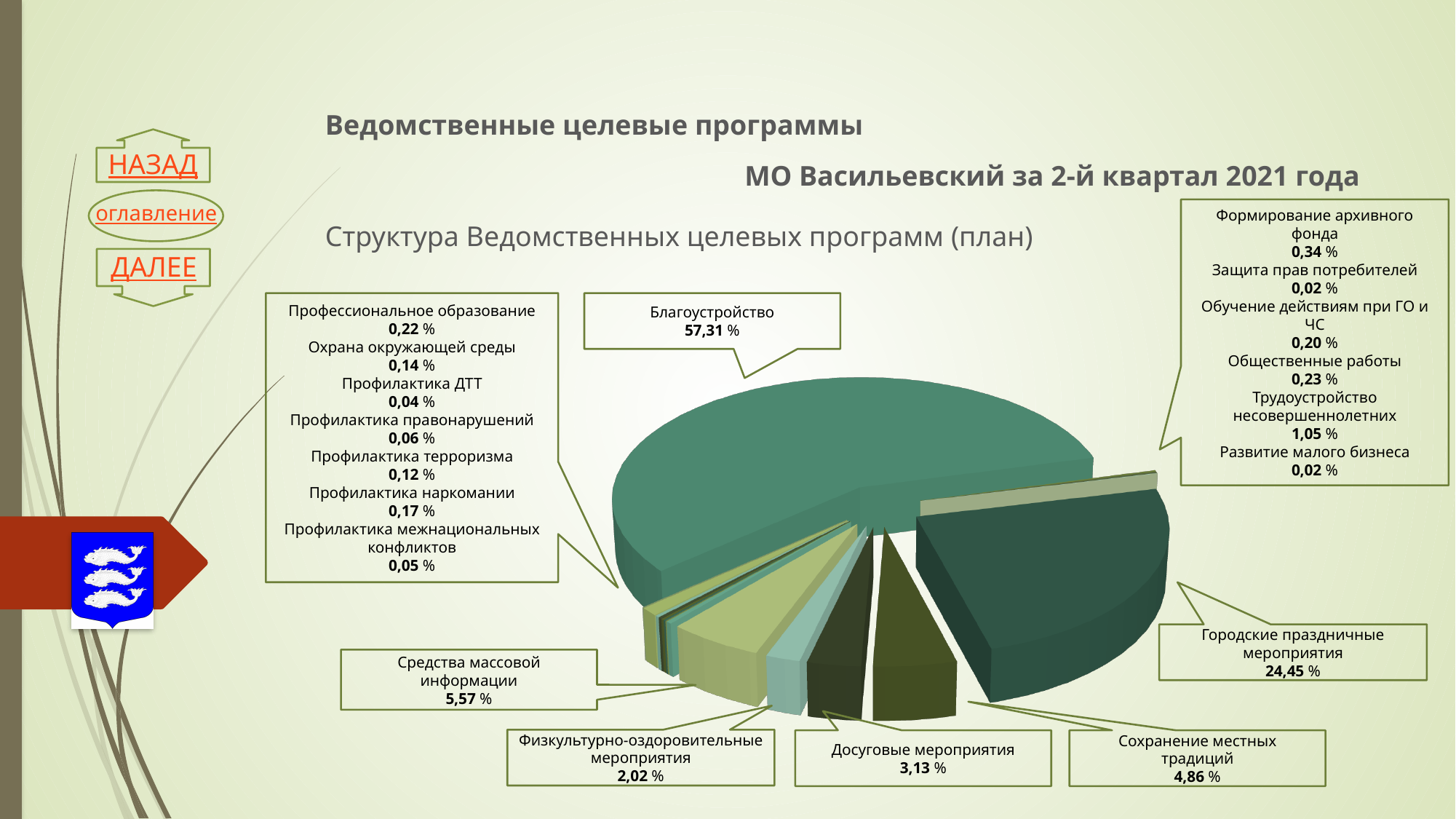
What is the value for Городские праздничные мероприятия? 24,45 % Which is larger: Формирование архивного фонда or Профилактика ДТТ? Формирование архивного фонда What is the title of the chart? Структура Ведомственных целевых программ (план) What is the value for Средства массовой информации? 5,57 % What kind of chart is shown on the slide? Pie chart What is the difference between the shares of Благоустройство and Городские праздничные мероприятия? 32,86 % How many categories are labelled on the chart? 19 What is the difference between the shares of Средства массовой информации and Сохранение местных традиций? 0,71 % Which is larger: Досуговые мероприятия or Физкультурно-оздоровительные мероприятия? Досуговые мероприятия What is the value for Трудоустройство несовершеннолетних? 1,05 % Which category has the largest share of the pie? Благоустройство What share does Благоустройство have in the pie chart? 57,31 %